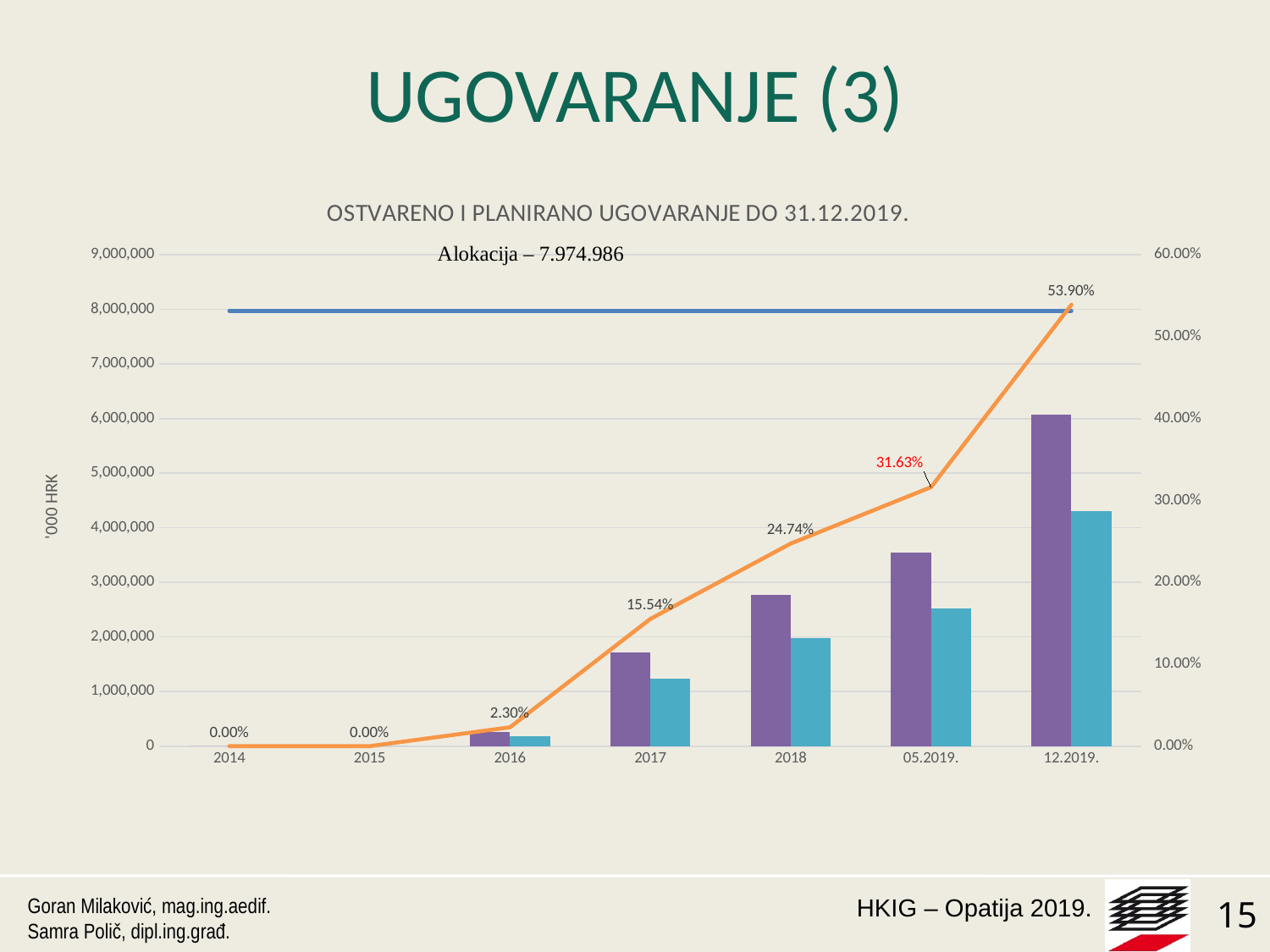
What is the percentage value shown on the line for 05.2019.? 31.63% How many categories are shown on the x axis? 7 Does the orange line rise or fall from 2014 to 12.2019.? rise Which is larger, the line percentage for 2018 or for 2017? 2018 Is the value of the purple bar for 2018 greater or less than 3,000,000? less What is the difference between the line percentage for 12.2019. and for 05.2019.? 22.27% Which category has the highest percentage value on the line? 12.2019. What is the percentage value shown on the line for 2016? 2.30% Is the value of the teal bar for 12.2019. greater or less than 4,000,000? greater What is the percentage value shown on the line for 2017? 15.54% What is the percentage value shown on the line for 12.2019.? 53.90% What value is given for 'Alokacija' on the chart? 7.974.986